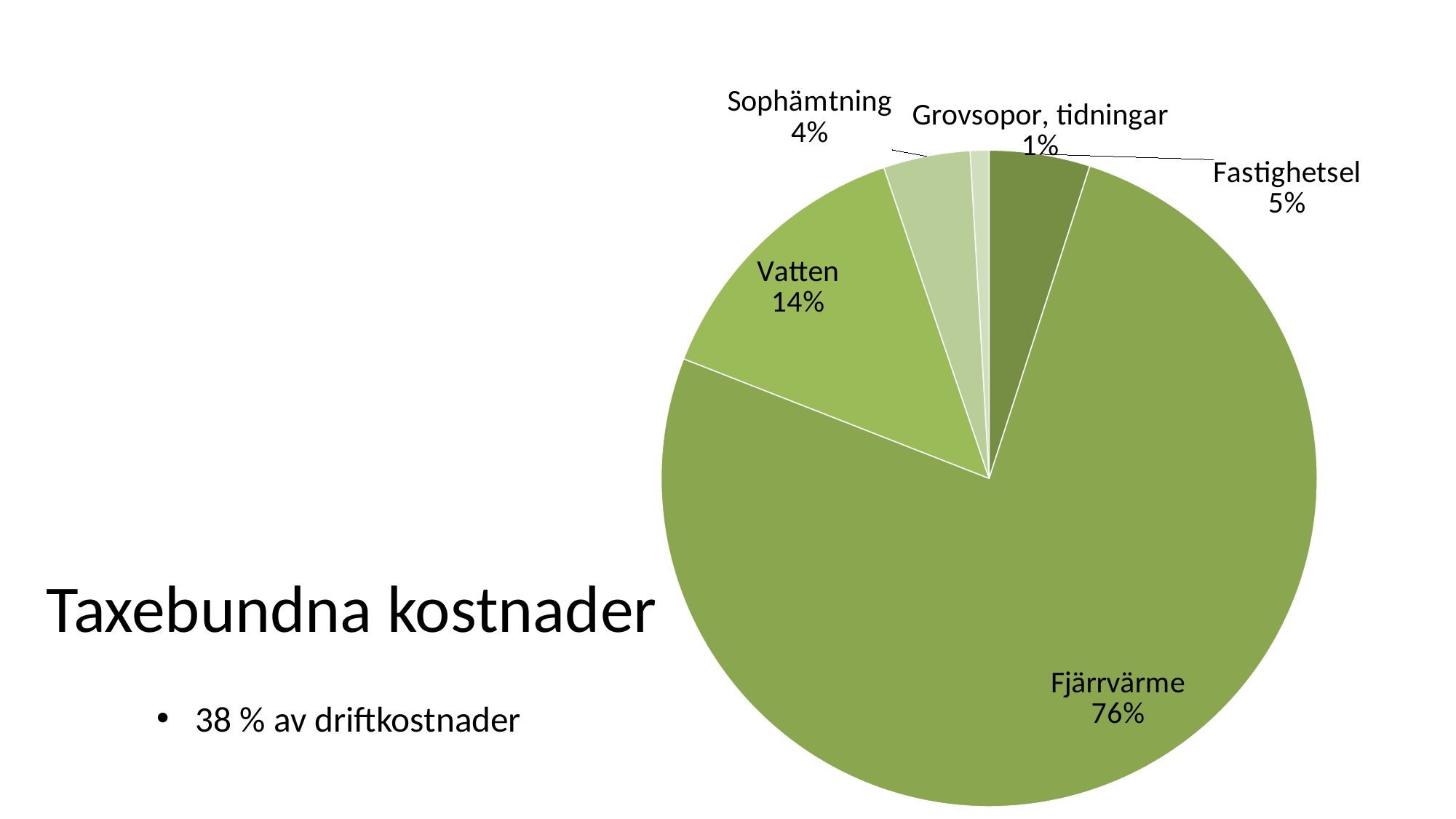
What share of the pie does Sophämtning account for? 4% What share of the pie does Fjärrvärme account for? 76% Which category has the largest slice of the pie? Fjärrvärme What kind of chart is shown on the slide? pie chart What share of the pie does Fastighetsel account for? 5% Which is larger, the share for Fastighetsel or the share for Sophämtning? Fastighetsel What is the difference in percentage points between Fjärrvärme and Vatten? 62 How many slices does the pie chart have? 5 Which category has the smallest slice of the pie? Grovsopor, tidningar What is the title text shown on the slide next to the pie chart? Taxebundna kostnader